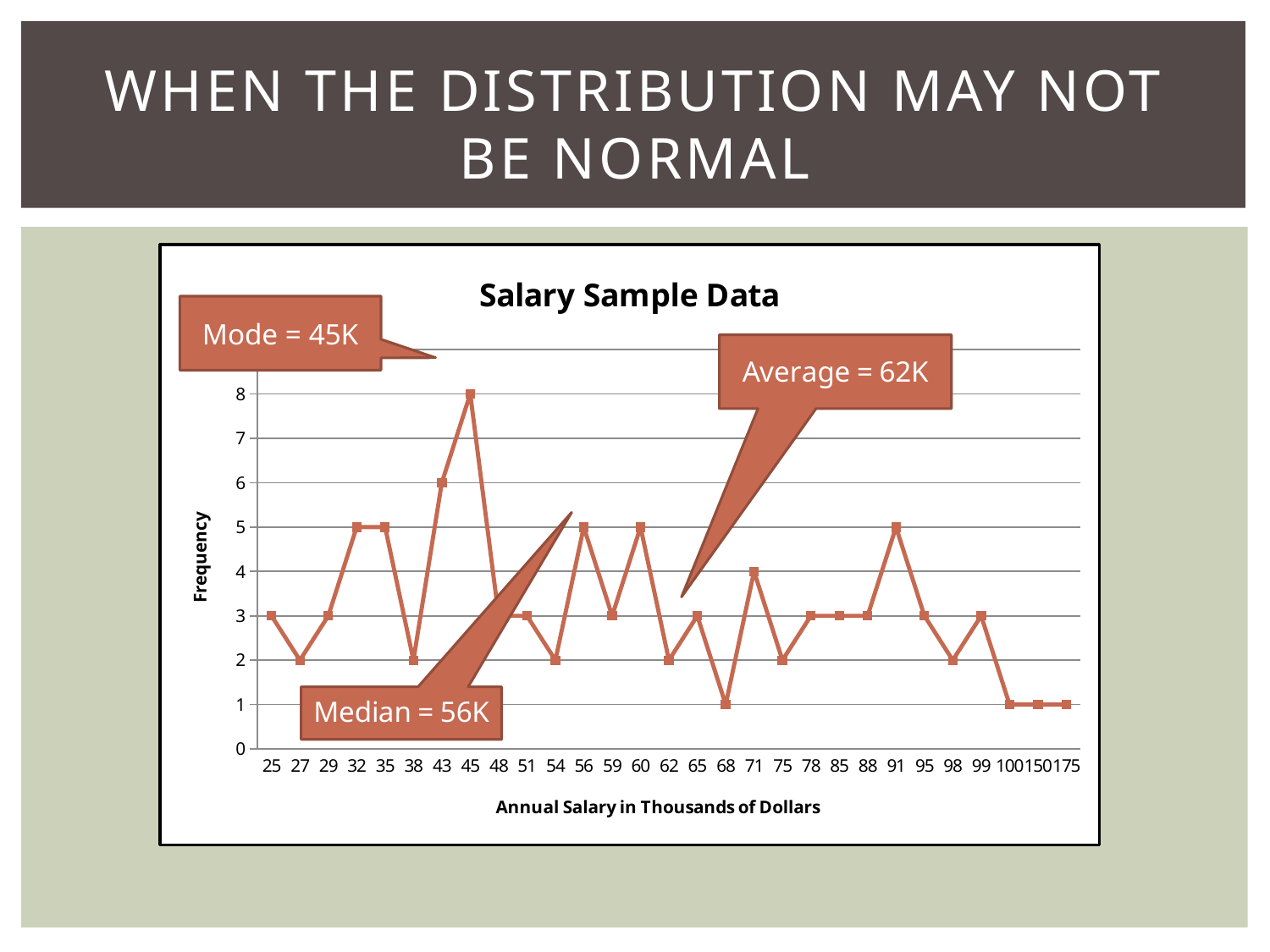
What is the frequency for an annual salary of 68 thousand dollars? 1 What type of chart is shown on the slide? line chart What is the frequency for an annual salary of 43 thousand dollars? 6 What is the lowest frequency shown on the chart? 1 Is the frequency for an annual salary of 45 greater or less than 6? greater What is the frequency for an annual salary of 45 thousand dollars? 8 Which annual salary value has the highest frequency? 45 How many salary values are plotted along the x axis? 29 What is the difference between the frequency at 45 and the frequency at 68? 7 What is the title of the chart? Salary Sample Data Which has a higher frequency, an annual salary of 43 or 38? 43 According to the callout on the chart, what is the average salary? 62K